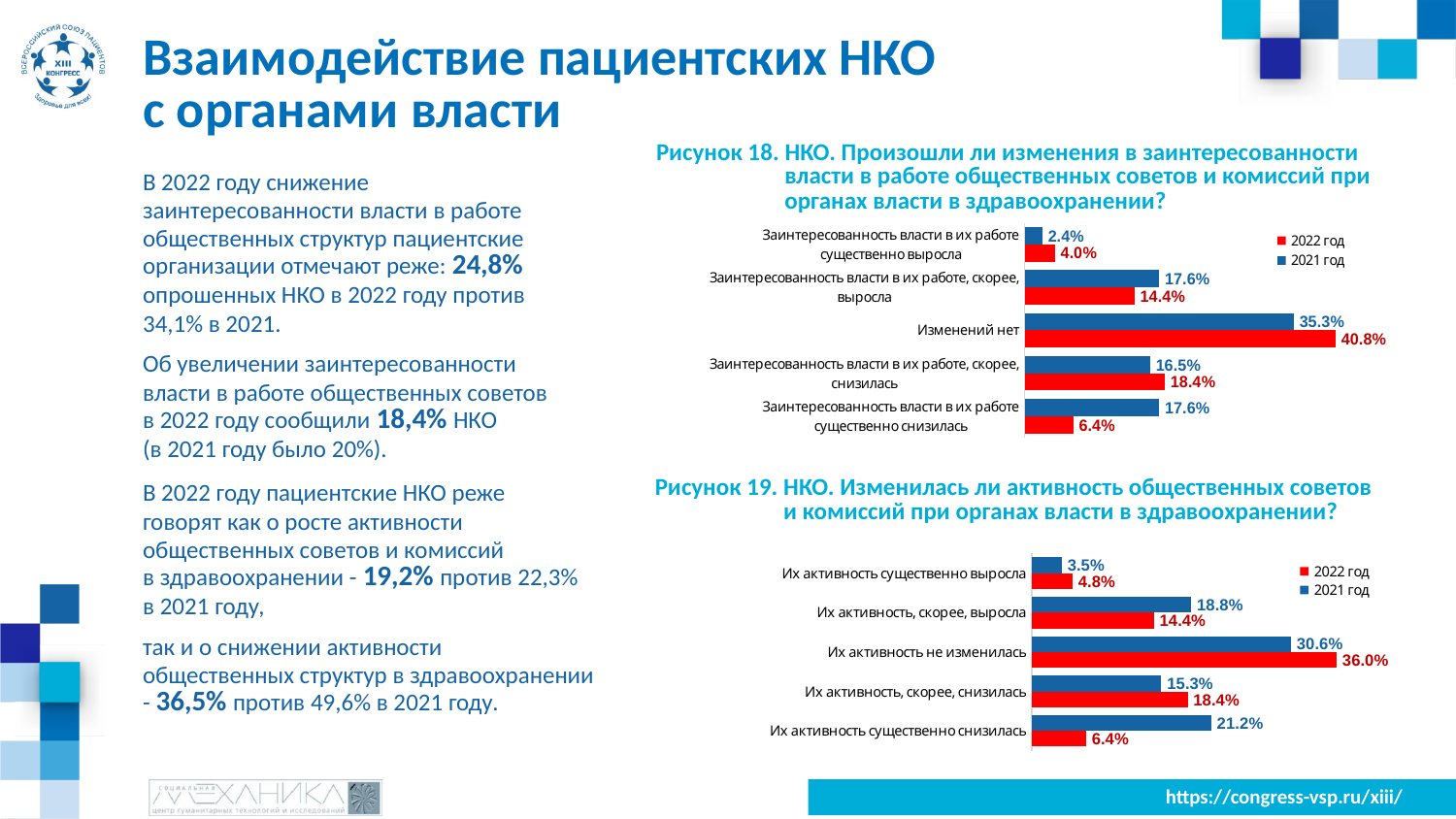
In the chart 'Рисунок 18', what is the 2021 год value for 'Заинтересованность власти в их работе существенно снизилась'? 17.6% In the chart 'Рисунок 18', which category has the lowest 2022 год value? Заинтересованность власти в их работе существенно выросла In the chart 'Рисунок 19', what is the 2022 год value for 'Их активность существенно снизилась'? 6.4% In the chart 'Рисунок 18', how many series does the legend list? 2 How many categories are shown in the chart 'Рисунок 19'? 5 In the chart 'Рисунок 18', which category has the highest 2021 год value? Изменений нет What type of chart is 'Рисунок 19'? Bar chart In the chart 'Рисунок 18', what is the 2022 год value for 'Изменений нет'? 40.8% In the chart 'Рисунок 19', what is the 2021 год value for 'Их активность, скорее, выросла'? 18.8% In the chart 'Рисунок 19', what is the difference between the 2021 год and 2022 год values for 'Их активность существенно снизилась'? 14.8% In the chart 'Рисунок 18', what is the difference between the 2022 год and 2021 год values for 'Изменений нет'? 5.5% In the chart 'Рисунок 19', which is larger for 'Их активность не изменилась': the 2022 год value or the 2021 год value? 2022 год